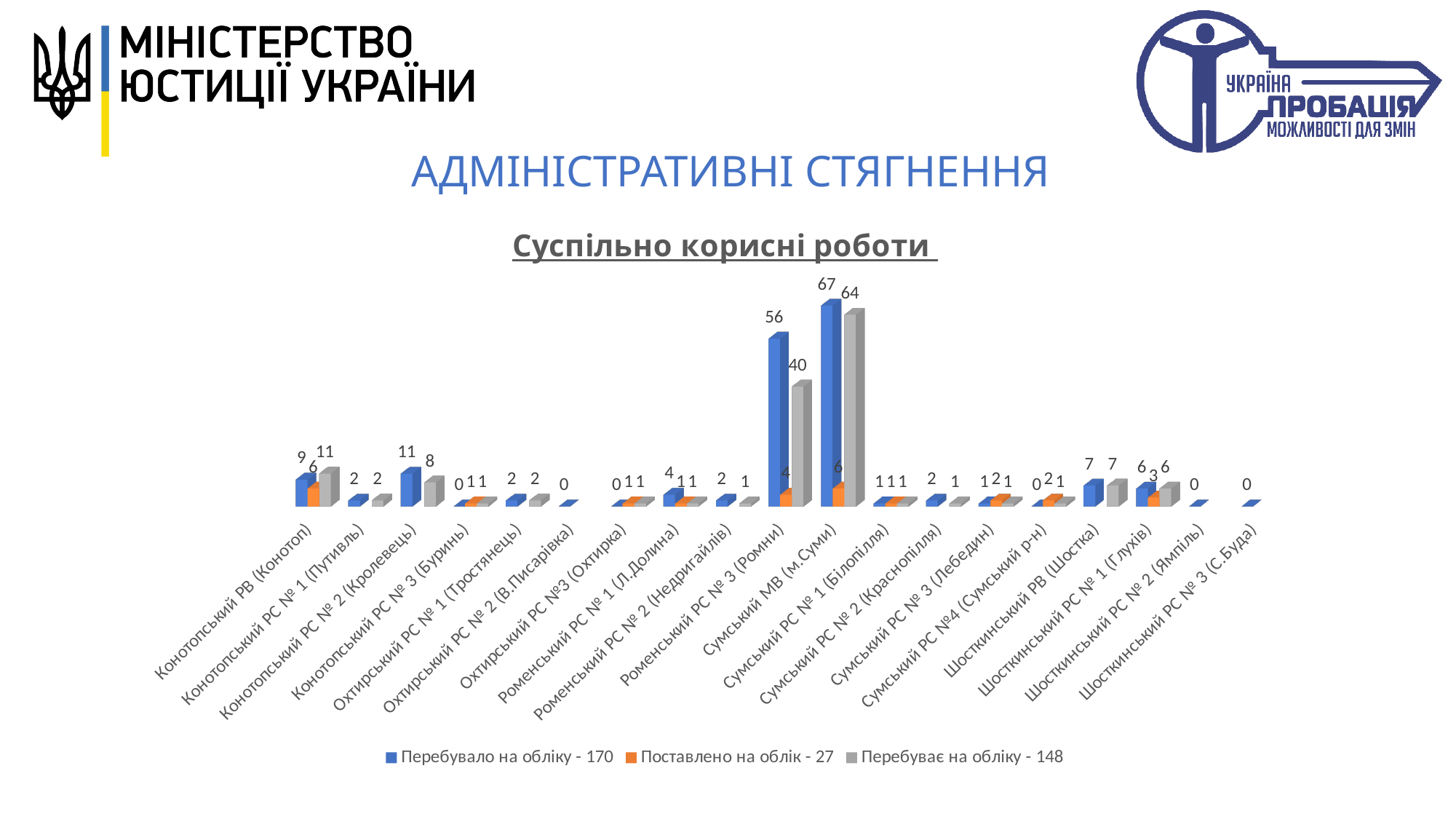
What total is shown in the legend entry for "Поставлено на облік"? 27 How many series does the legend of the chart list? 3 What is the difference between the "Перебуває на обліку" values for Сумський МВ (м.Суми) and Роменський РС № 3 (Ромни)? 24 What is the difference between the "Перебувало на обліку" values for Сумський МВ (м.Суми) and Роменський РС № 3 (Ромни)? 11 For Роменський РС № 3 (Ромни), which is larger: "Перебувало на обліку" or "Перебуває на обліку"? Перебувало на обліку How many categories (offices) are shown along the x axis of the chart? 19 What is the value of "Поставлено на облік" for Сумський МВ (м.Суми)? 6 What is the value of "Перебуває на обліку" for Конотопський РВ (Конотоп)? 11 What is the value of "Перебуває на обліку" for Роменський РС № 3 (Ромни)? 40 What kind of chart is shown under the title "Суспільно корисні роботи"? Bar chart What is the value of "Перебувало на обліку" for Сумський МВ (м.Суми)? 67 Which category has the highest value of "Перебувало на обліку"? Сумський МВ (м.Суми)